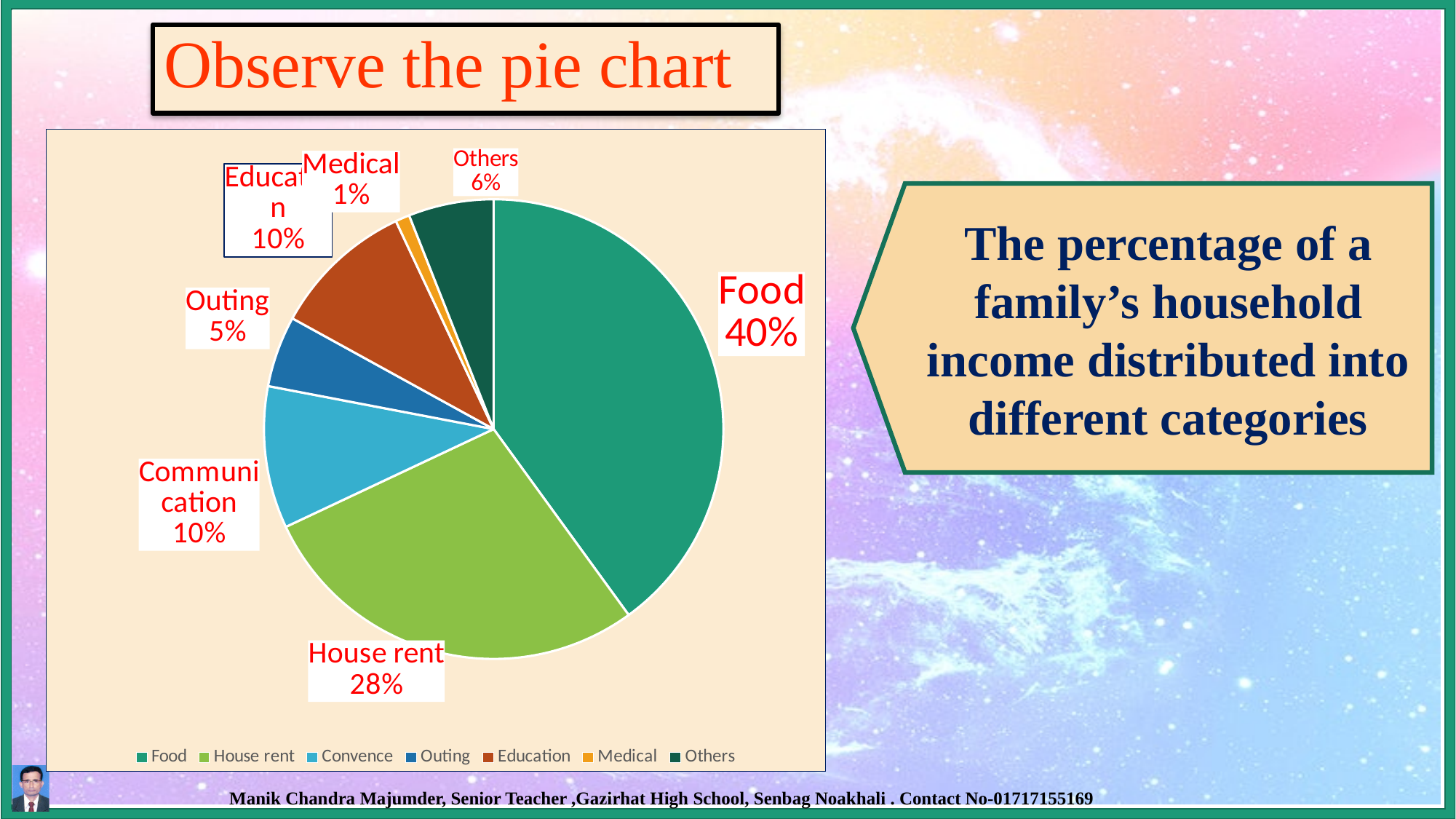
What percentage is shown for Others? 6% What percentage is shown for Medical? 1% What is the title shown in the box above the chart? Observe the pie chart Which category has the smallest share of the pie? Medical Which category has the largest share of the pie? Food What percentage of household income goes to House rent? 28% How many entries does the legend list? 7 What is the difference in percentage points between Food and House rent? 12 Which is larger, the share for Outing or the share for Others? Others How many slices does the pie chart have? 7 What type of chart is shown on the slide? Pie chart What percentage of household income goes to Food? 40%